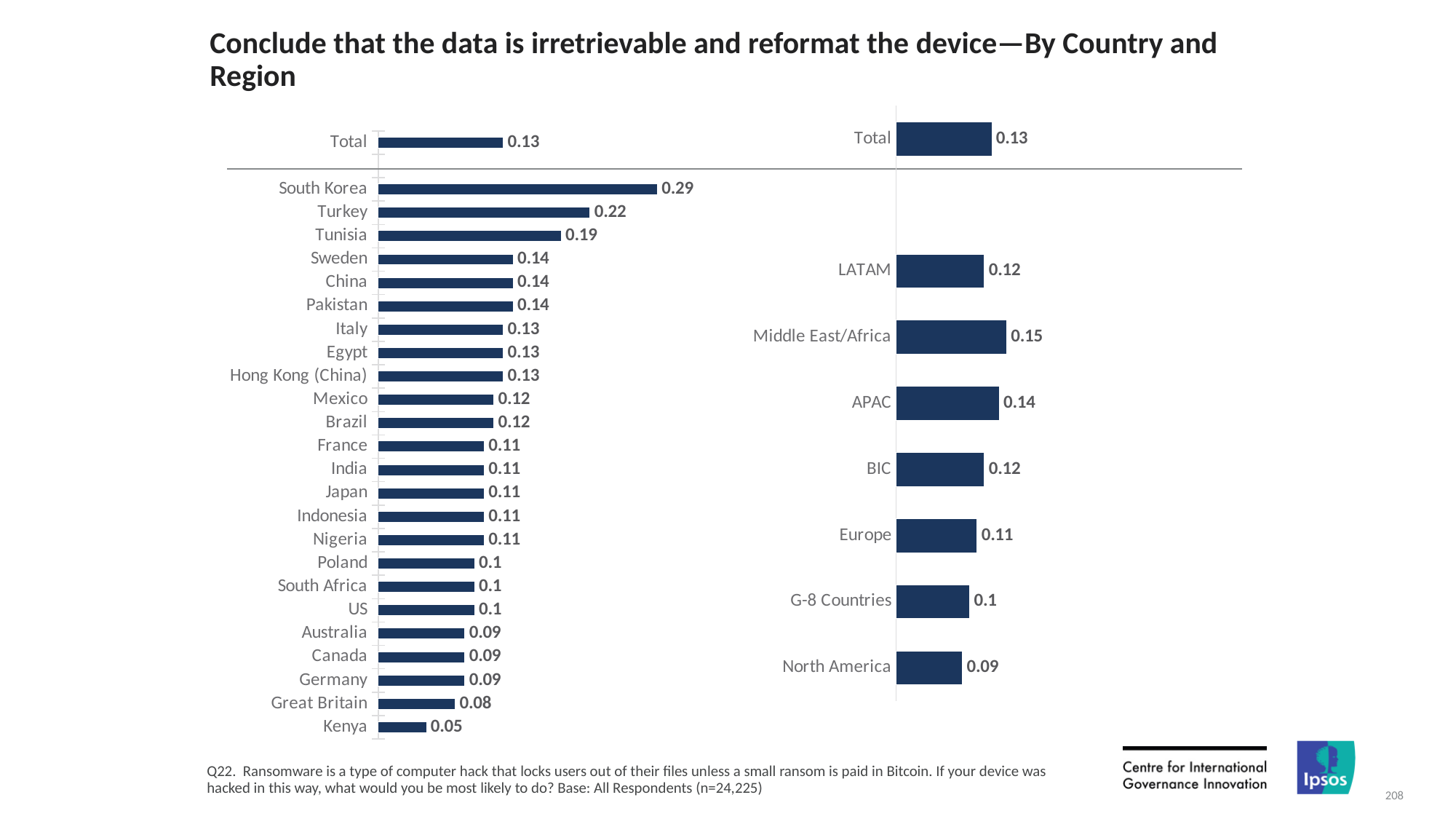
In the left chart (by country), which has the larger value, Tunisia or Sweden? Tunisia In the right chart (by region), what is the difference between the values for APAC and Europe? 0.03 In the left chart (by country), what is the difference between the values for South Korea and Turkey? 0.07 In the right chart (by region), what is the value for Middle East/Africa? 0.15 In the right chart (by region), which region has the highest value? Middle East/Africa In the left chart (by country), how many countries are listed below the Total bar? 24 What type of chart is used on this slide? Bar chart In the left chart (by country), which country has the lowest value? Kenya In the right chart (by region), which region has the lowest value? North America In the left chart (by country), what is the value for Kenya? 0.05 In the left chart (by country), which country has the highest value? South Korea In the left chart (by country), what is the value for South Korea? 0.29